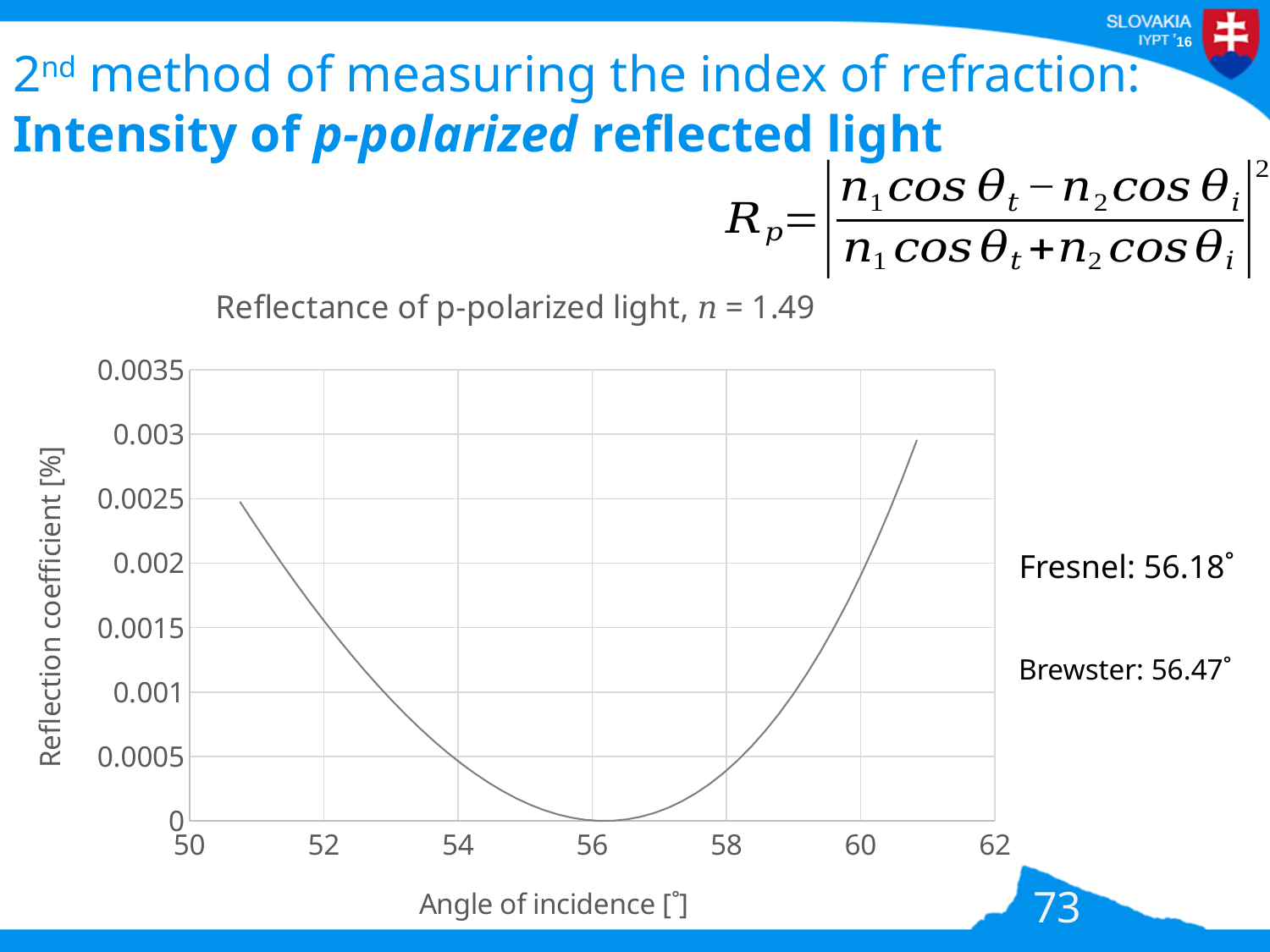
What kind of chart is shown on the slide? line chart Is the reflection coefficient at an angle of incidence of 60° greater or less than 0.001? greater Does the reflection coefficient rise or fall as the angle of incidence increases from 51° to 56°? fall Which is larger, the reflection coefficient at 51° or at 59°? 51° What is the title of the chart? Reflectance of p-polarized light, n = 1.49 Is the reflection coefficient at an angle of incidence of 58° greater or less than 0.001? less Is the reflection coefficient at an angle of incidence of 52° greater or less than 0.001? greater Does the reflection coefficient rise or fall as the angle of incidence increases from 57° to 61°? rise What is the label of the x axis of the chart? Angle of incidence [°] What is the highest value shown on the y axis of the chart? 0.0035